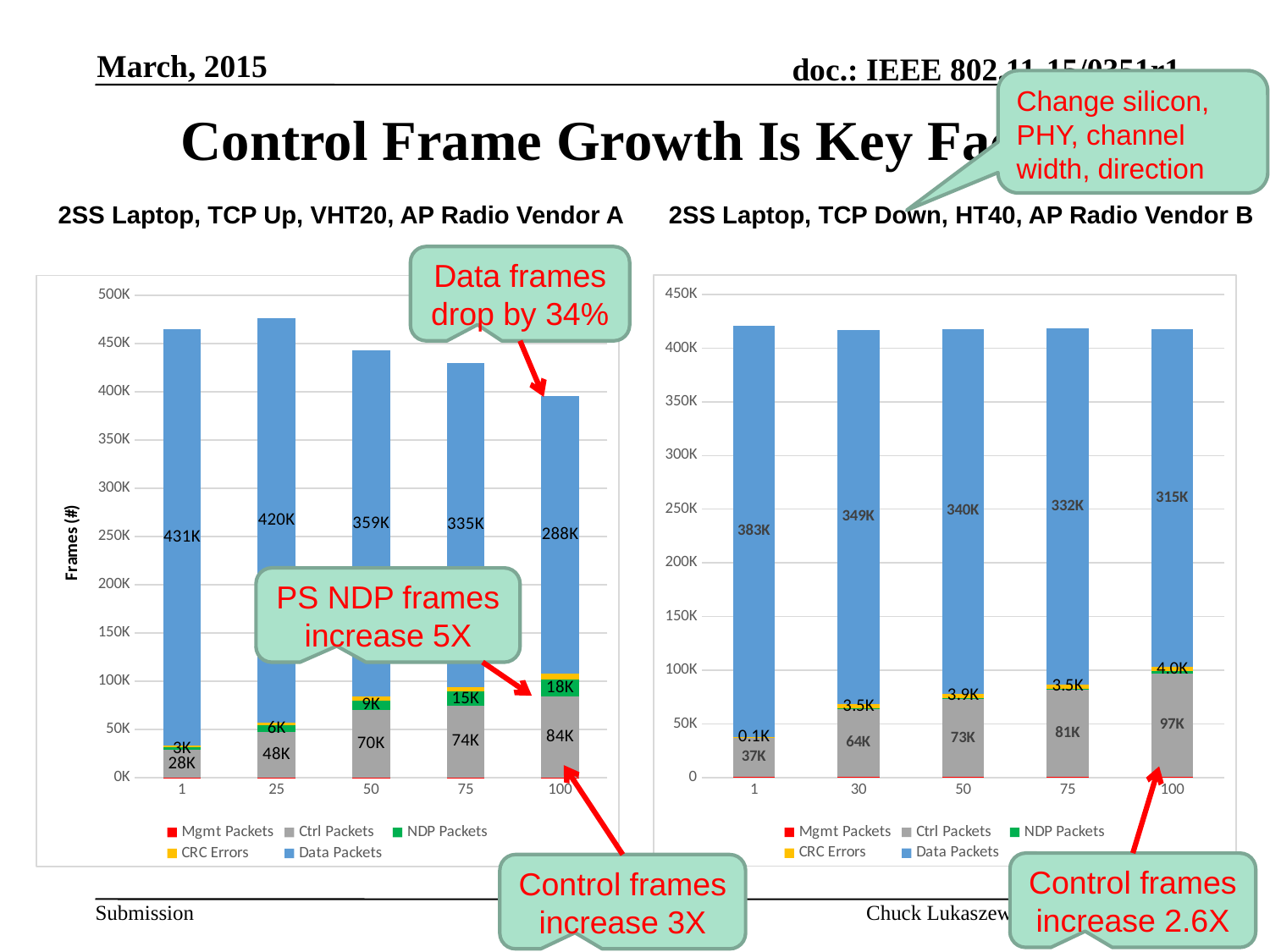
In the right chart (2SS Laptop, TCP Down, HT40, AP Radio Vendor B), is the total height of the stacked bar at category 1 greater or less than 400K? greater In the left chart (2SS Laptop, TCP Up, VHT20, AP Radio Vendor A), what is the Data Packets value at category 1? 431K Do the Data Packets values in the left chart (2SS Laptop, TCP Up, VHT20, AP Radio Vendor A) rise or fall from category 25 to category 100? fall In the left chart (2SS Laptop, TCP Up, VHT20, AP Radio Vendor A), which category has the highest NDP Packets value? 100 In the left chart (2SS Laptop, TCP Up, VHT20, AP Radio Vendor A), what is the Ctrl Packets value at category 100? 84K In the right chart (2SS Laptop, TCP Down, HT40, AP Radio Vendor B), what is the Data Packets value at category 30? 349K How many series does the legend of the right chart (2SS Laptop, TCP Down, HT40, AP Radio Vendor B) list? 5 How many categories are shown on the x axis of the left chart (2SS Laptop, TCP Up, VHT20, AP Radio Vendor A)? 5 In the right chart (2SS Laptop, TCP Down, HT40, AP Radio Vendor B), which is larger: the Ctrl Packets value at category 50 or at category 100? 100 In the right chart (2SS Laptop, TCP Down, HT40, AP Radio Vendor B), which category has the lowest Ctrl Packets value? 1 In the right chart (2SS Laptop, TCP Down, HT40, AP Radio Vendor B), what is the Ctrl Packets value at category 75? 81K In the left chart (2SS Laptop, TCP Up, VHT20, AP Radio Vendor A), what is the difference between the Data Packets values at category 1 and category 100? 143K